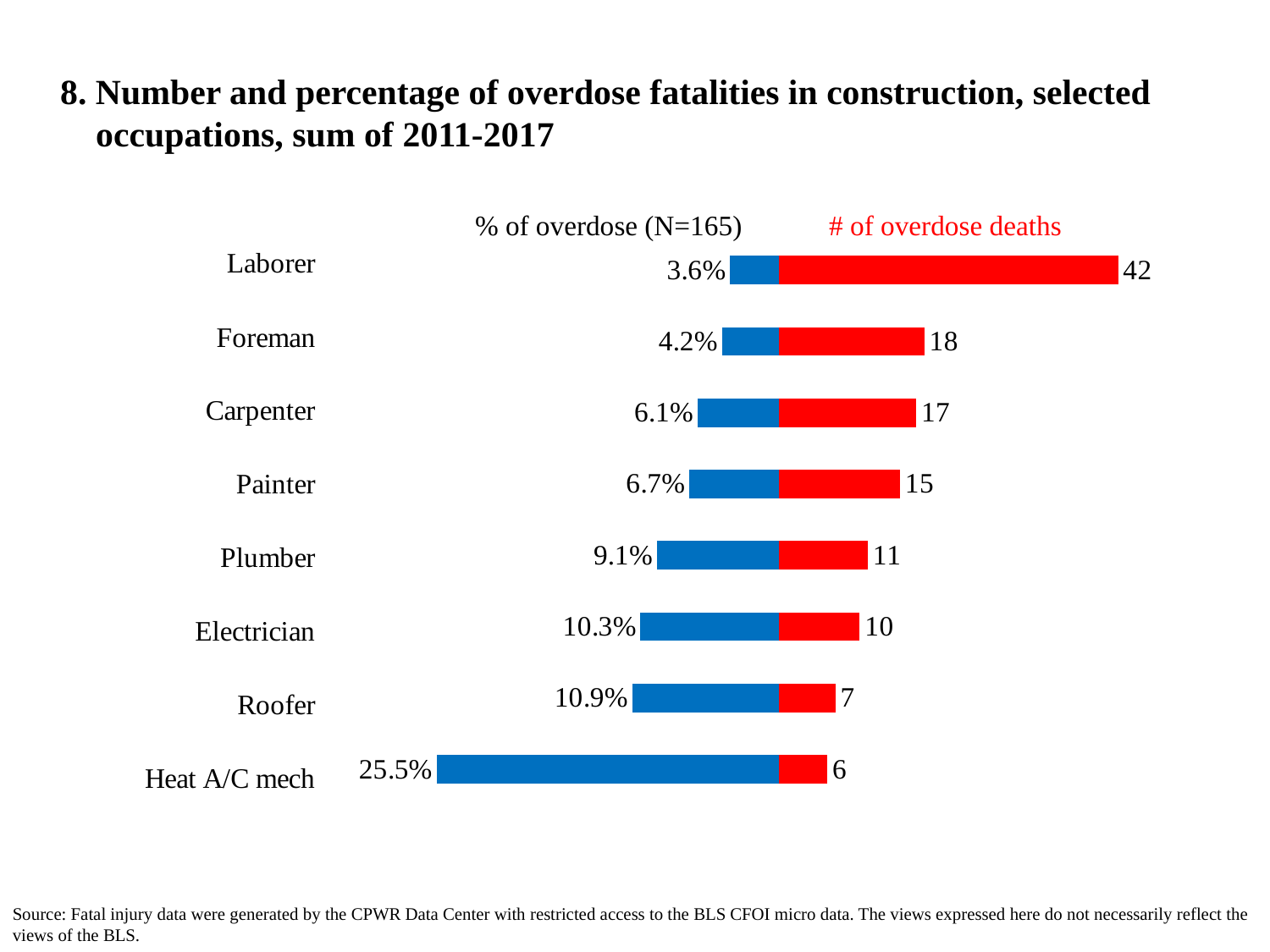
What is the number of overdose deaths for Laborer? 42 What is the % of overdose for Heat A/C mech? 25.5% Which has more overdose deaths, Carpenter or Electrician? Carpenter Which occupation has the lowest % of overdose? Laborer What is the number of overdose deaths for Painter? 15 What type of chart is shown on the slide? Bar chart What is the % of overdose for Plumber? 9.1% What is the difference in number of overdose deaths between Laborer and Foreman? 24 Which occupation has the highest % of overdose? Heat A/C mech How many occupations are shown in the chart? 8 How many series does the chart show? 2 Which occupation has the highest number of overdose deaths? Laborer